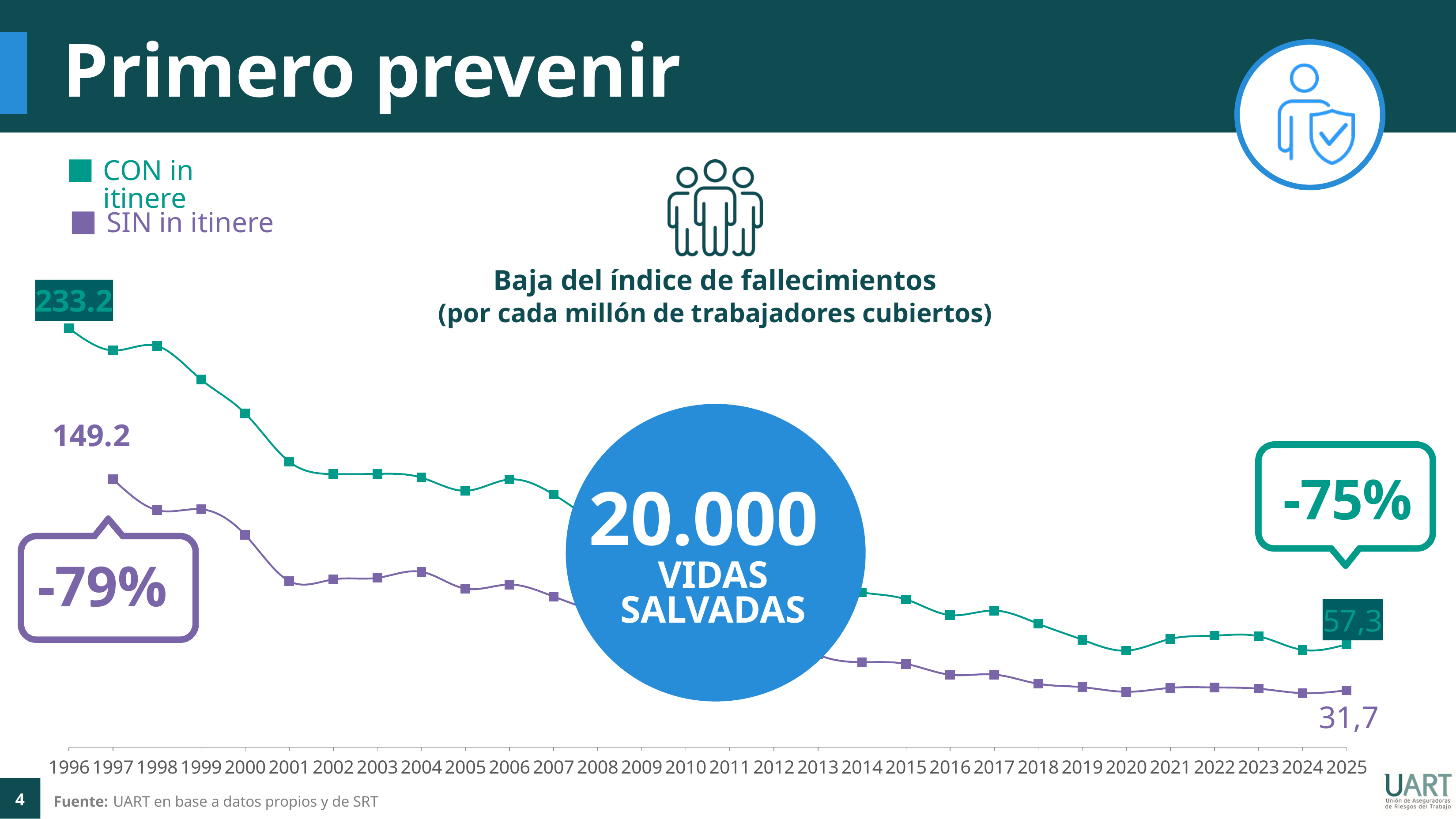
What are the two series named in the legend? CON in itinere and SIN in itinere What kind of chart is shown on the slide? line chart Do the values of the CON in itinere series rise or fall from 1996 to 2025? fall Which series has the higher value in 2025, CON in itinere or SIN in itinere? CON in itinere What is the value of the SIN in itinere series in 2025? 31,7 How many years are shown on the x axis? 30 What is the first labelled value of the SIN in itinere series? 149.2 What is the value of the CON in itinere series in 2025? 57,3 What percentage change is shown in the callout for the SIN in itinere series? -79% What is the value of the CON in itinere series in 1996? 233.2 How many series does the legend list? 2 In which year does the CON in itinere series reach its highest value? 1996